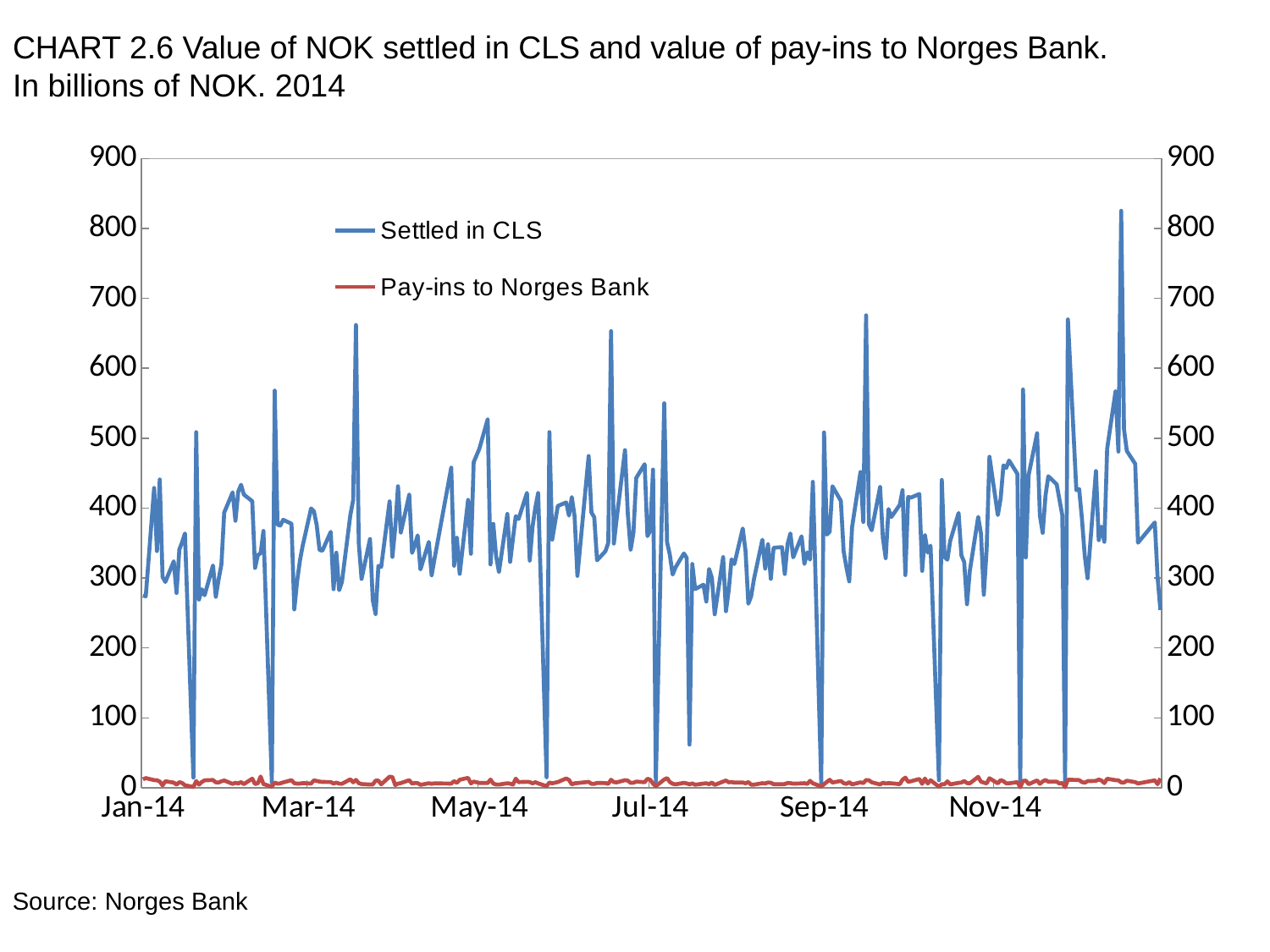
How many series does the legend list? 2 What are the two series named in the legend? Settled in CLS; Pay-ins to Norges Bank What colour is the line for Pay-ins to Norges Bank? Red Which series reaches the highest value on the chart? Settled in CLS Is the highest peak of the Settled in CLS line greater or less than 800? greater What is the maximum value shown on the vertical axis? 900 Which series stays lowest throughout the year? Pay-ins to Norges Bank Which series is larger in value for most of 2014, Settled in CLS or Pay-ins to Norges Bank? Settled in CLS In which month does the Settled in CLS line reach its highest peak? December 2014 Is the Pay-ins to Norges Bank line ever greater or less than 100 during 2014? less How many month labels are shown on the horizontal axis? 6 What kind of chart is shown on the slide? Line chart